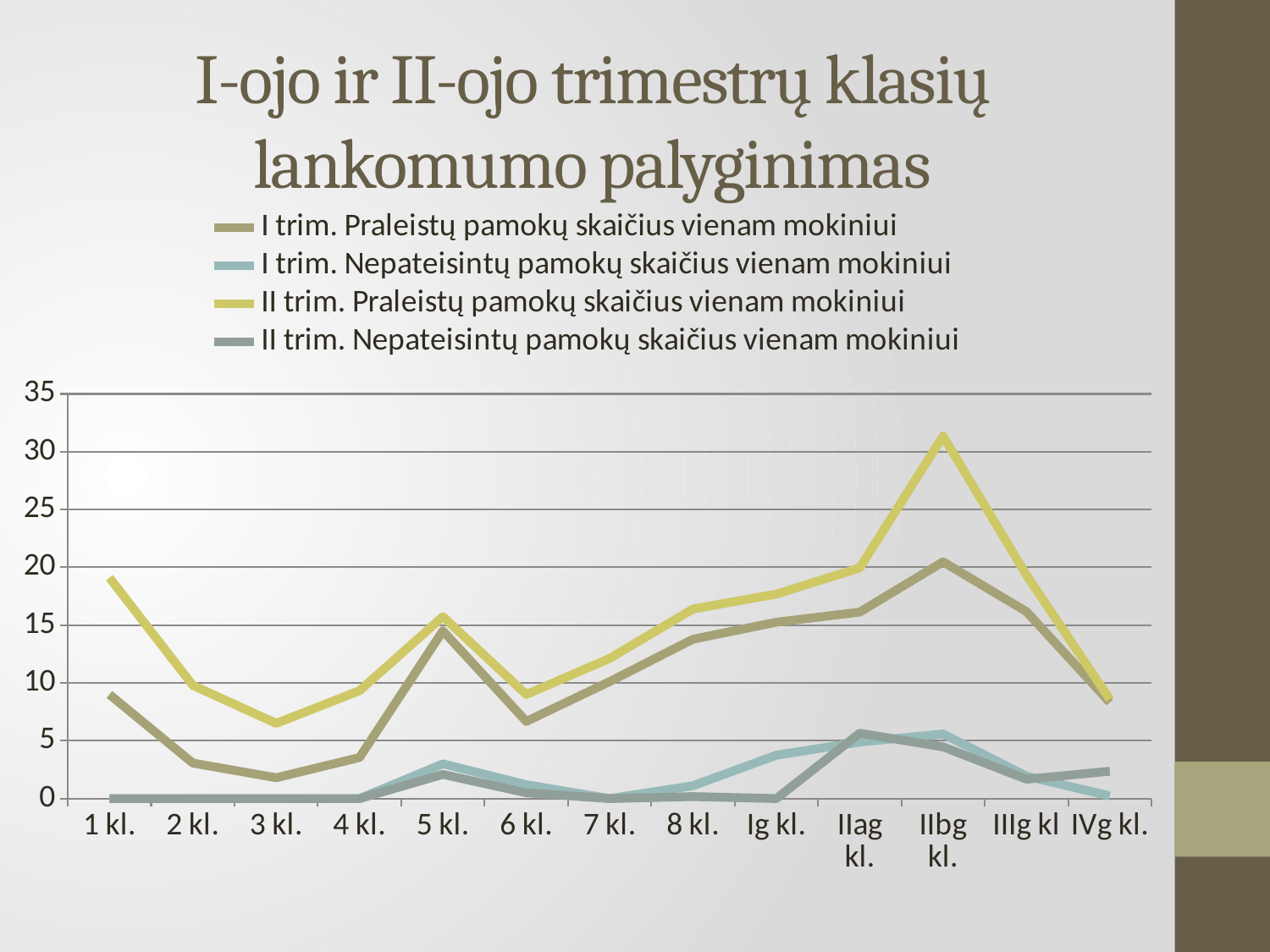
Is the value of 'I trim. Praleistų pamokų skaičius vienam mokiniui' for 3 kl. greater or less than 5? less For which class is the value of 'I trim. Praleistų pamokų skaičius vienam mokiniui' highest? IIbg kl. Does the value of 'II trim. Praleistų pamokų skaičius vienam mokiniui' rise or fall from IIbg kl. to IVg kl.? fall How many series does the legend list? 4 For 1 kl., which is larger: 'I trim. Praleistų pamokų skaičius vienam mokiniui' or 'II trim. Praleistų pamokų skaičius vienam mokiniui'? II trim. Praleistų pamokų skaičius vienam mokiniui How many class categories are shown along the x axis? 13 For which class is the value of 'II trim. Praleistų pamokų skaičius vienam mokiniui' lowest? 3 kl. Is the value of 'II trim. Praleistų pamokų skaičius vienam mokiniui' for 1 kl. greater or less than 15? greater For which class is the value of 'II trim. Praleistų pamokų skaičius vienam mokiniui' highest? IIbg kl. What kind of chart is shown on the slide? line chart Is the value of 'II trim. Praleistų pamokų skaičius vienam mokiniui' for IIbg kl. greater or less than 25? greater What is the title of the chart slide? I-ojo ir II-ojo trimestrų klasių lankomumo palyginimas